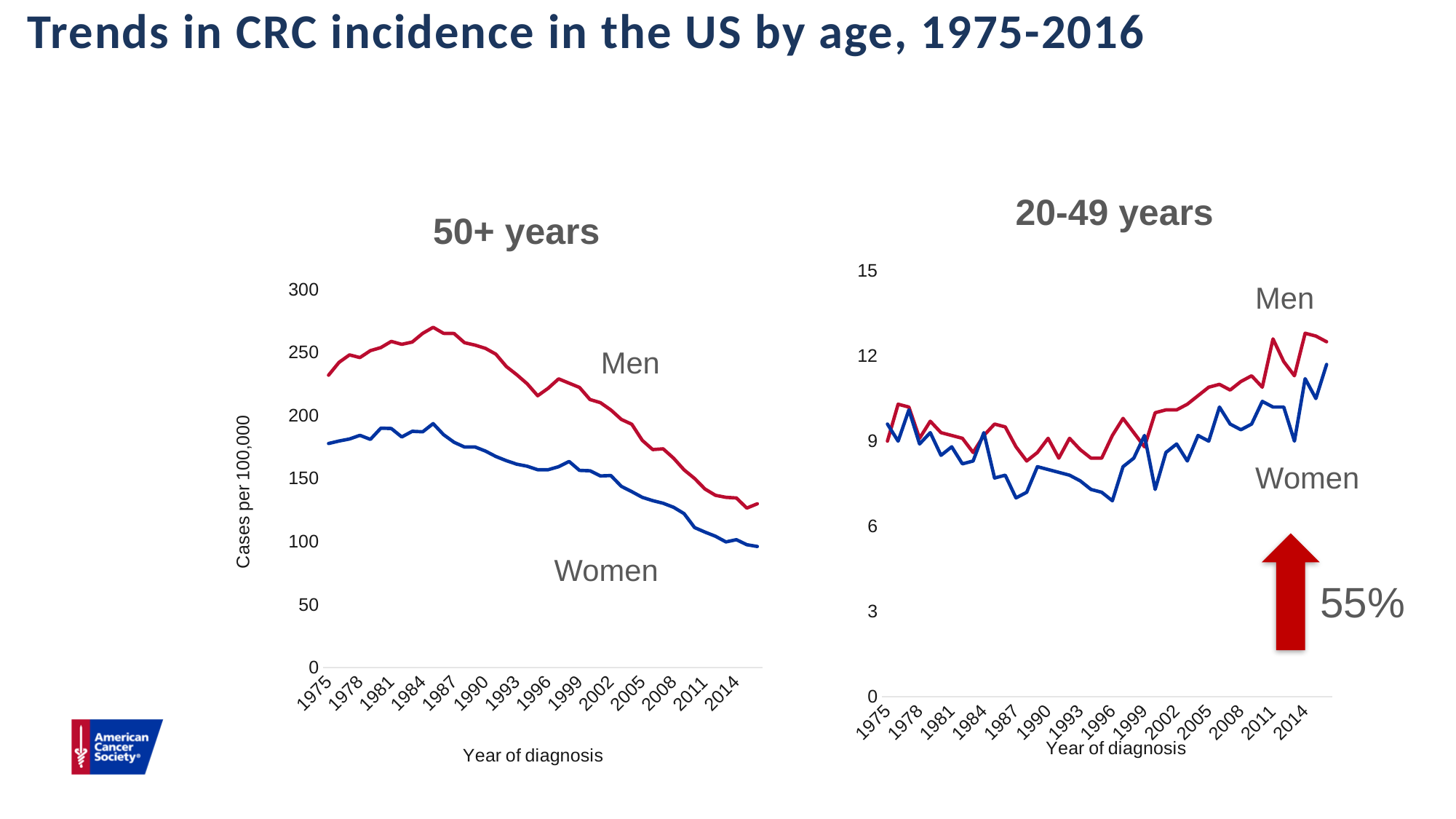
What is the y-axis label of the "50+ years" chart? Cases per 100,000 What kind of chart is the "50+ years" chart? line chart In the "50+ years" chart, which series has the higher value in 1975, Men or Women? Men In the "20-49 years" chart, is the value for Women in 1987 greater or less than 9? less In the "50+ years" chart, is the value for Women in 2016 greater or less than 150? less In the "20-49 years" chart, do the values for Men rise or fall from 1996 to 2016? rise In the "20-49 years" chart, is the value for Men in 2016 greater or less than 12? greater In the "50+ years" chart, do the values for Men rise or fall from 1990 to 2016? fall In the "50+ years" chart, how many series are plotted? 2 In the "20-49 years" chart, which series has the higher value in 2016, Men or Women? Men